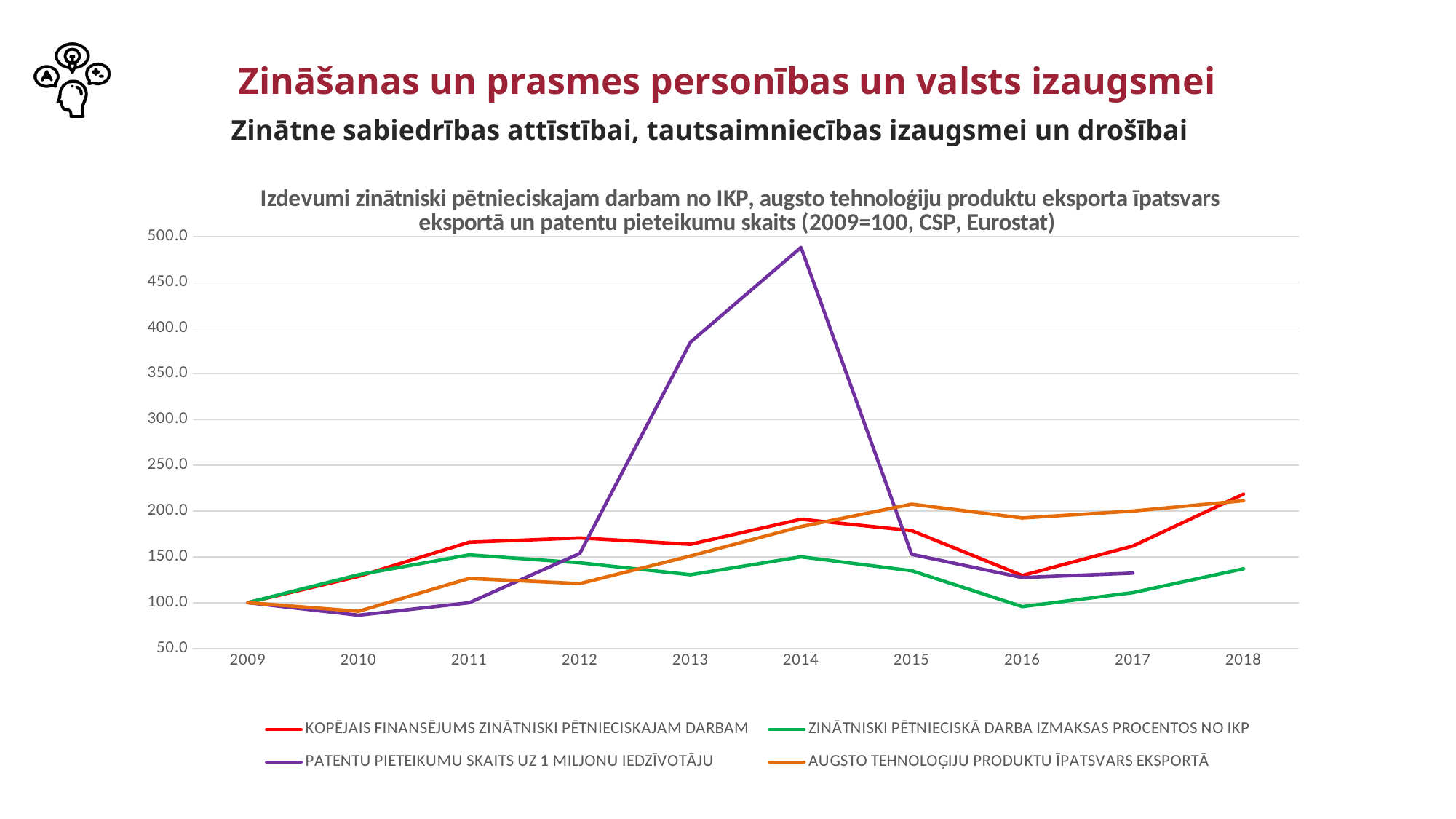
In 2014, which is larger: PATENTU PIETEIKUMU SKAITS UZ 1 MILJONU IEDZĪVOTĀJU or KOPĒJAIS FINANSĒJUMS ZINĀTNISKI PĒTNIECISKAJAM DARBAM? PATENTU PIETEIKUMU SKAITS UZ 1 MILJONU IEDZĪVOTĀJU In which year does PATENTU PIETEIKUMU SKAITS UZ 1 MILJONU IEDZĪVOTĀJU reach its highest value? 2014 In which year is PATENTU PIETEIKUMU SKAITS UZ 1 MILJONU IEDZĪVOTĀJU at its lowest? 2010 Does KOPĒJAIS FINANSĒJUMS ZINĀTNISKI PĒTNIECISKAJAM DARBAM rise or fall from 2016 to 2018? rise How many series does the legend list? 4 Is the value for ZINĀTNISKI PĒTNIECISKĀ DARBA IZMAKSAS PROCENTOS NO IKP in 2013 greater or less than 150? less Is the value for PATENTU PIETEIKUMU SKAITS UZ 1 MILJONU IEDZĪVOTĀJU in 2014 greater or less than 450? greater What colour is the line for PATENTU PIETEIKUMU SKAITS UZ 1 MILJONU IEDZĪVOTĀJU? purple What kind of chart is shown on the slide? line chart What is the value of PATENTU PIETEIKUMU SKAITS UZ 1 MILJONU IEDZĪVOTĀJU in 2009? 100.0 How many years are shown on the x axis? 10 Is the value for AUGSTO TEHNOLOĢIJU PRODUKTU ĪPATSVARS EKSPORTĀ in 2010 greater or less than 100? less